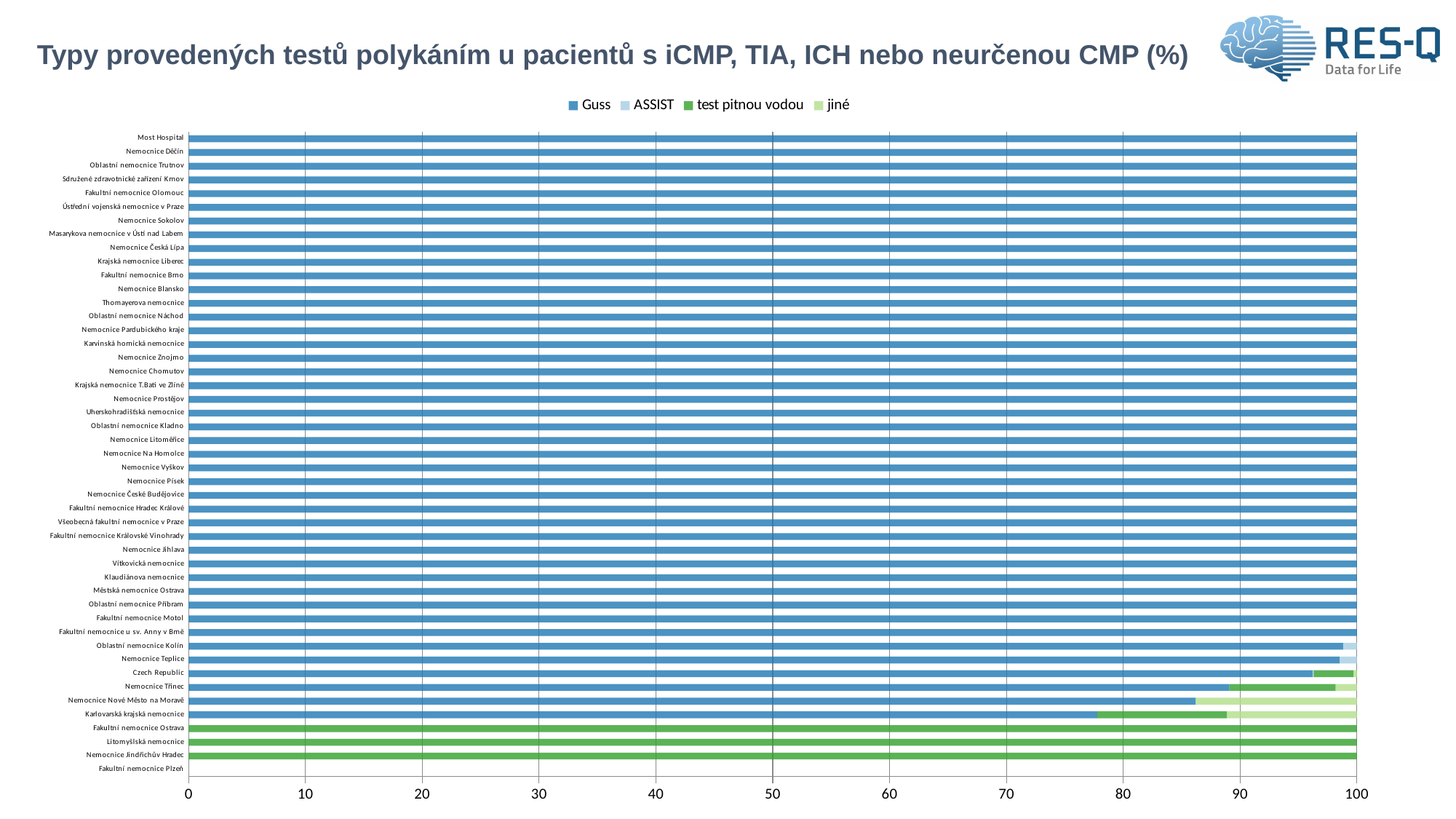
What kind of chart is shown on the slide? stacked bar chart Which has the larger Guss value, Nemocnice Třinec or Karlovarská krajská nemocnice? Nemocnice Třinec Which series are listed in the legend? Guss, ASSIST, test pitnou vodou, jiné What is the 'test pitnou vodou' value for Fakultní nemocnice Ostrava? 100 Is the Guss value for Karlovarská krajská nemocnice greater or less than 80? less Is the Guss value for Czech Republic greater or less than 90? greater Which hospital has no bar plotted at all? Fakultní nemocnice Plzeň What is the Guss value for Most Hospital? 100 Is the Guss value for Nemocnice Nové Město na Moravě greater or less than 90? less How many series does the legend list? 4 How many hospitals/categories are listed on the vertical axis? 47